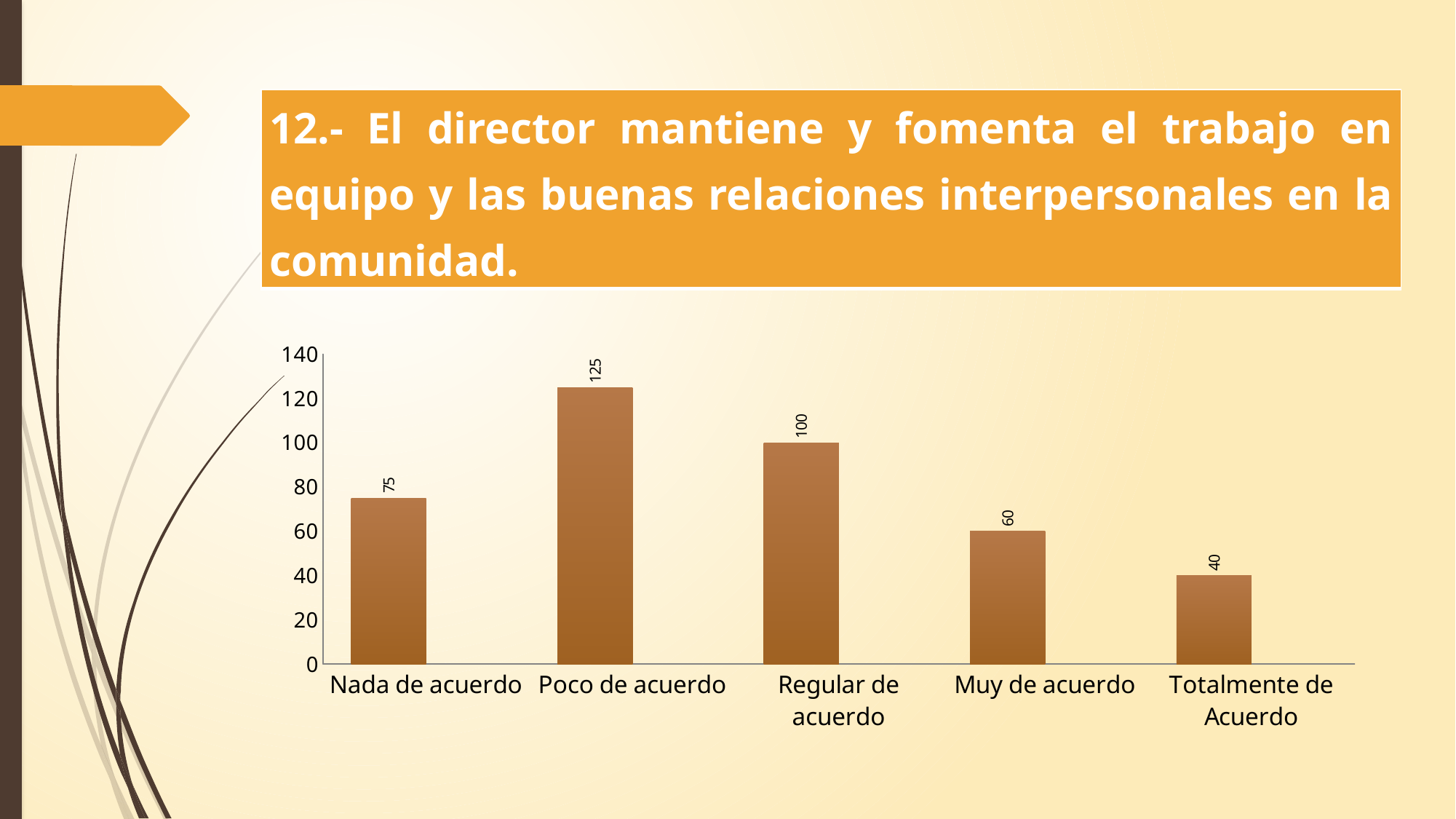
Is the value for Regular de acuerdo greater or less than 120? less What is the value for Totalmente de Acuerdo? 40 What kind of chart is shown on the slide? bar chart Which is larger, the value for Muy de acuerdo or the value for Nada de acuerdo? Nada de acuerdo Which category has the lowest value? Totalmente de Acuerdo What is the highest value shown on the vertical axis? 140 What is the value for Regular de acuerdo? 100 What is the total of the values for Muy de acuerdo and Totalmente de Acuerdo? 100 Which category has the highest value? Poco de acuerdo How many categories are shown on the x axis? 5 What is the difference between the values for Poco de acuerdo and Nada de acuerdo? 50 What is the value for Poco de acuerdo? 125